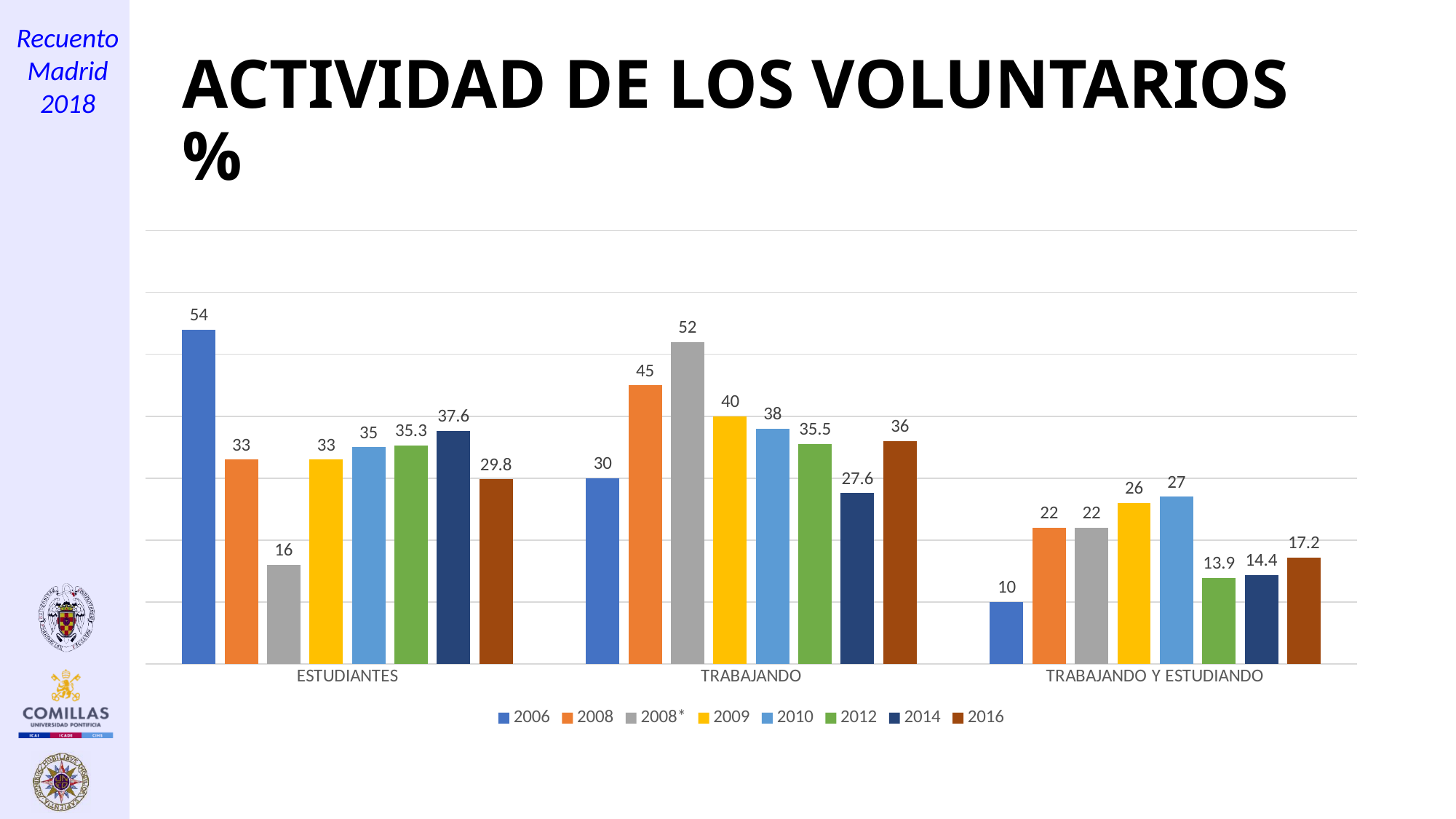
Which series has the highest value in the TRABAJANDO Y ESTUDIANDO category? 2010 Which is larger: the 2012 value for ESTUDIANTES or the 2012 value for TRABAJANDO? TRABAJANDO How many categories are shown on the x axis? 3 What is the title of the slide? ACTIVIDAD DE LOS VOLUNTARIOS % What is the difference between the 2006 value for ESTUDIANTES and the 2006 value for TRABAJANDO? 24 What is the value for 2014 in the ESTUDIANTES category? 37.6 How many series does the legend list? 8 What is the value for 2016 in the TRABAJANDO Y ESTUDIANDO category? 17.2 What is the value for 2008* in the TRABAJANDO category? 52 Which series has the lowest value in the ESTUDIANTES category? 2008* What is the value for 2006 in the ESTUDIANTES category? 54 What kind of chart is shown on the slide? bar chart